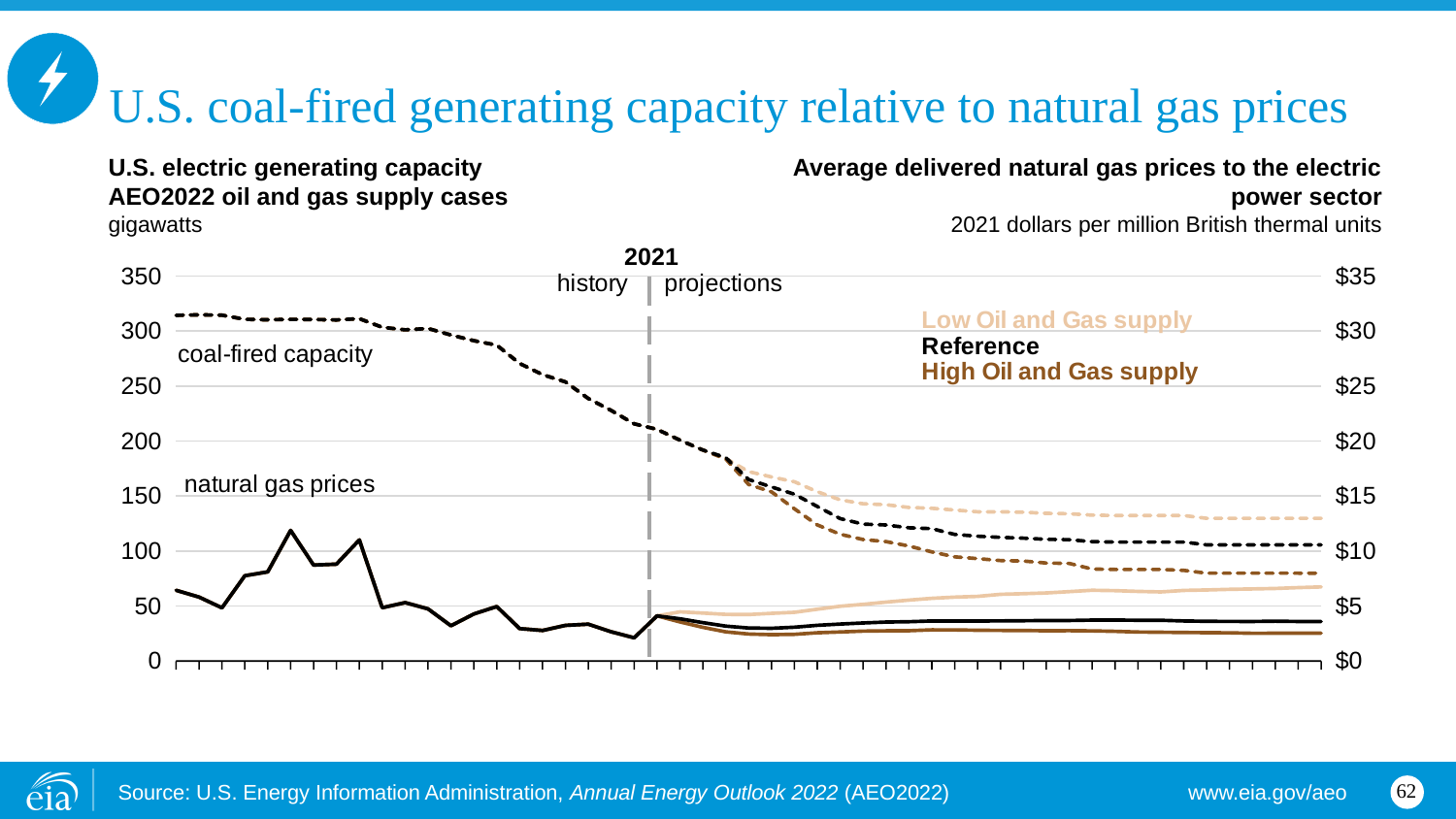
At the end of the projection period, which case has higher coal-fired capacity: Low Oil and Gas supply or High Oil and Gas supply? Low Oil and Gas supply Which year separates history from projections on the chart? 2021 How many oil and gas supply cases does the legend list? 3 Which case has the highest natural gas price at the end of the projection period? Low Oil and Gas supply Is coal-fired capacity in the Reference case at the end of the projection period greater or less than 150 gigawatts? less Is the highest historical natural gas price shown greater or less than $10? greater Is the natural gas price in the Low Oil and Gas supply case at the end of the projection period greater or less than $5? greater What kind of chart is shown on the slide? line chart Does coal-fired capacity rise or fall over the projection period? fall What unit is used on the left axis of the chart? gigawatts